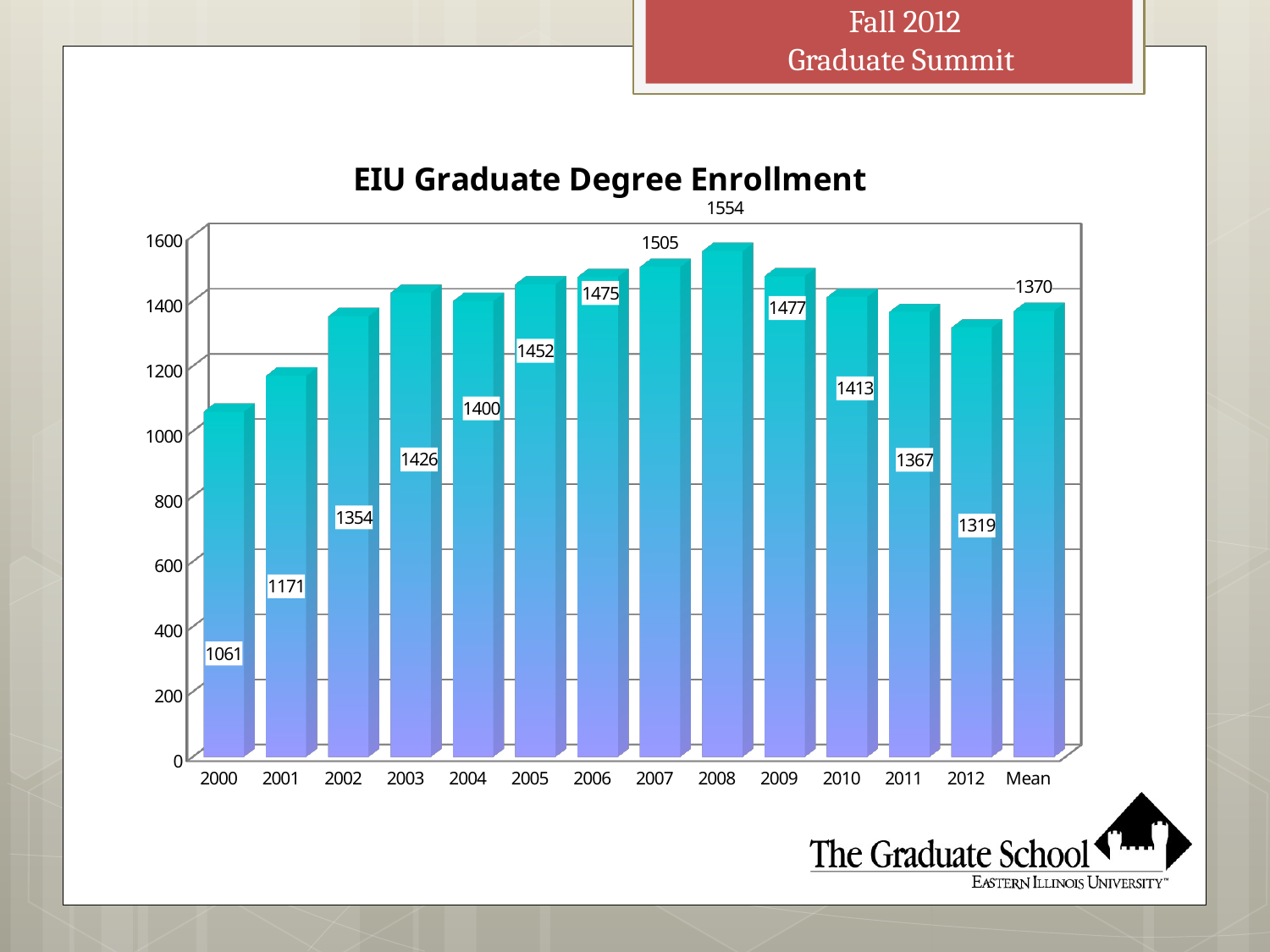
What is the difference between the enrollment in 2011 and the enrollment in 2012? 48 What is the title of the chart? EIU Graduate Degree Enrollment What was the EIU graduate degree enrollment in 2000? 1061 What was the EIU graduate degree enrollment in 2008? 1554 What type of chart is shown on the slide? bar chart Which year had the lowest graduate degree enrollment? 2000 Which year had the highest graduate degree enrollment? 2008 How many bars are shown in the chart, including the Mean bar? 14 What is the difference between the enrollment in 2008 and the enrollment in 2000? 493 What is the value shown for the Mean bar? 1370 Did enrollment rise or fall from 2008 to 2012? fall Which year had a higher enrollment, 2003 or 2012? 2003